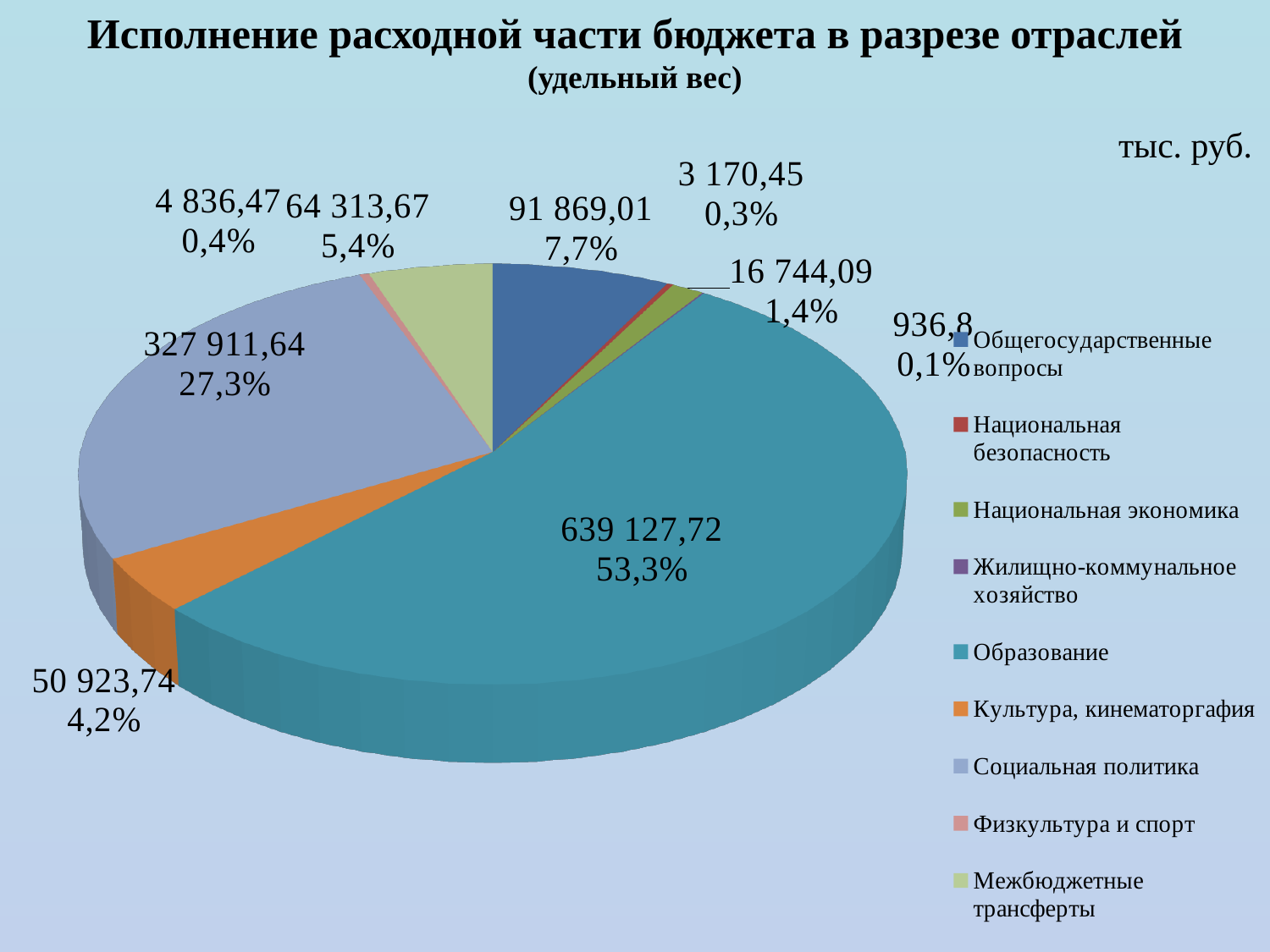
What share of the pie does Общегосударственные вопросы hold? 7,7% Which category has the smallest slice of the pie? Жилищно-коммунальное хозяйство What share of the pie does Социальная политика hold? 27,3% What value is shown for Социальная политика? 327 911,64 How many categories does the legend of the pie chart list? 9 What is the difference between the values for Образование and Социальная политика? 311 216,08 What share of the pie does Образование hold? 53,3% What unit is indicated for the values on the chart? тыс. руб. What value is shown for Образование? 639 127,72 What kind of chart is shown on the slide? pie chart Which is larger, the value for Культура, кинематография or the value for Межбюджетные трансферты? Межбюджетные трансферты Which category has the largest slice of the pie? Образование